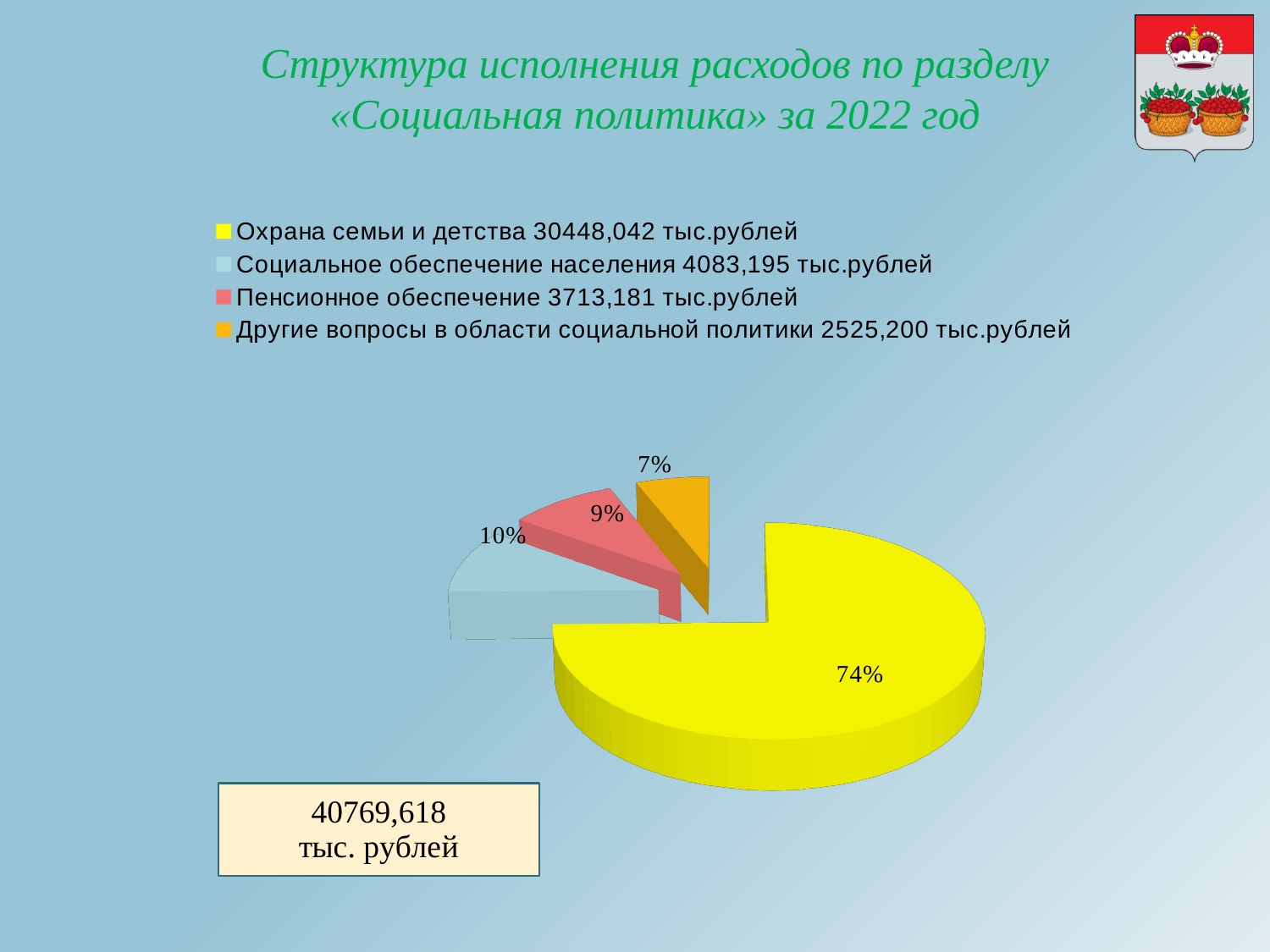
What share of the pie does «Пенсионное обеспечение» take? 9% How many entries does the legend list? 4 Which is larger: «Социальное обеспечение населения» or «Пенсионное обеспечение»? Социальное обеспечение населения What share of the pie does «Другие вопросы в области социальной политики» take? 7% What kind of chart is shown on the slide? pie chart What is the difference between «Социальное обеспечение населения» (4083,195) and «Пенсионное обеспечение» (3713,181) in тыс.рублей? 370,014 What share of the pie does «Социальное обеспечение населения» take? 10% How many slices does the pie chart have? 4 Which category has the smallest share of the pie? Другие вопросы в области социальной политики What is the value for «Охрана семьи и детства» according to the legend? 30448,042 тыс.рублей What is the value for «Пенсионное обеспечение» according to the legend? 3713,181 тыс.рублей